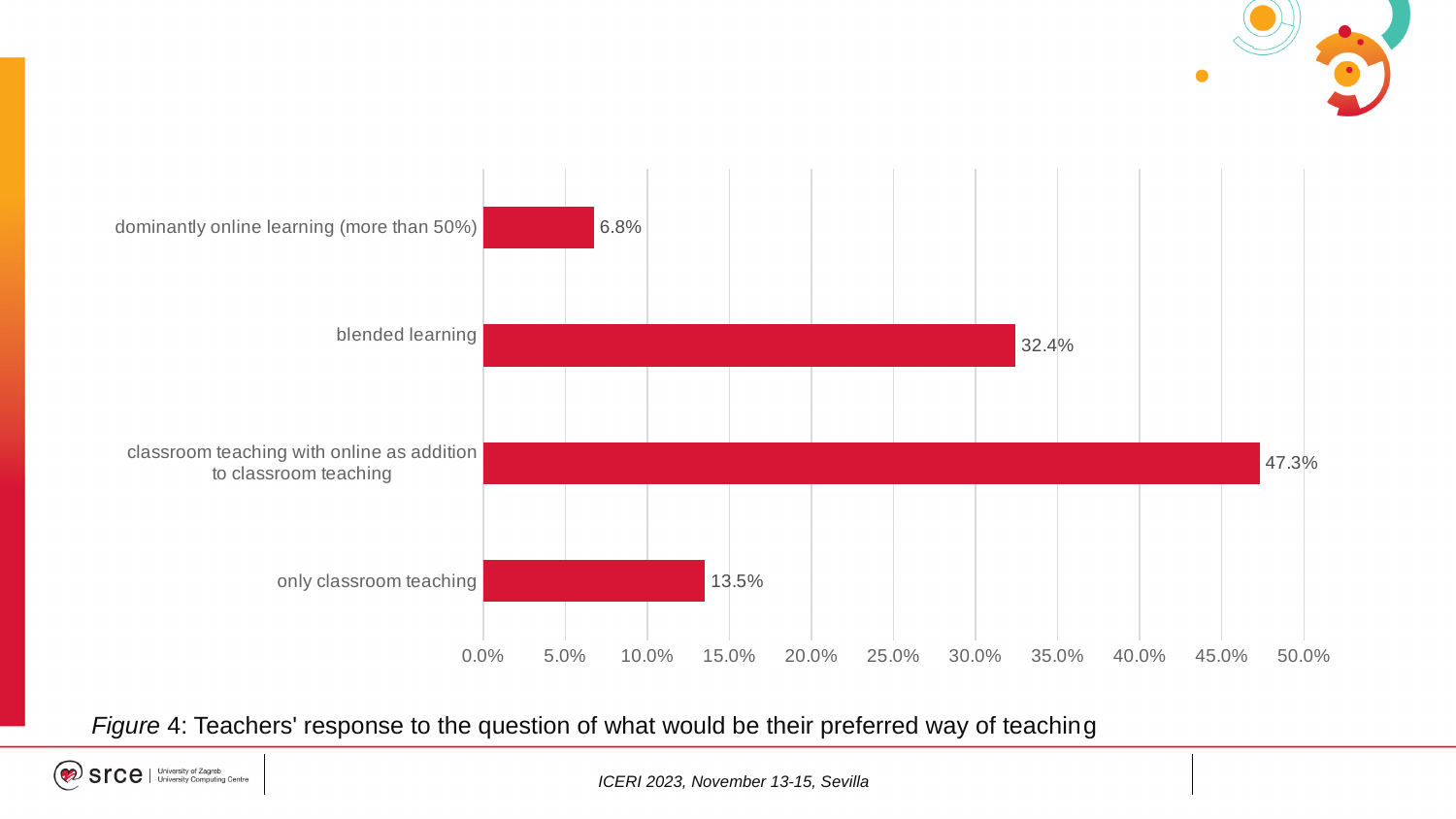
What is the value for 'only classroom teaching'? 13.5% What kind of chart is shown on the slide? bar chart Which category has the highest value? classroom teaching with online as addition to classroom teaching What is the maximum value shown on the x axis? 50.0% Is the value for 'blended learning' greater or less than 30.0%? greater Which is larger: the value for 'only classroom teaching' or for 'dominantly online learning (more than 50%)'? only classroom teaching What percentage of teachers preferred blended learning? 32.4% What is the difference between the values for 'classroom teaching with online as addition to classroom teaching' and 'blended learning'? 14.9% What is the value for 'dominantly online learning (more than 50%)'? 6.8% What is the figure caption below the chart? Figure 4: Teachers' response to the question of what would be their preferred way of teaching How many categories are shown in the chart? 4 Which category has the lowest value? dominantly online learning (more than 50%)